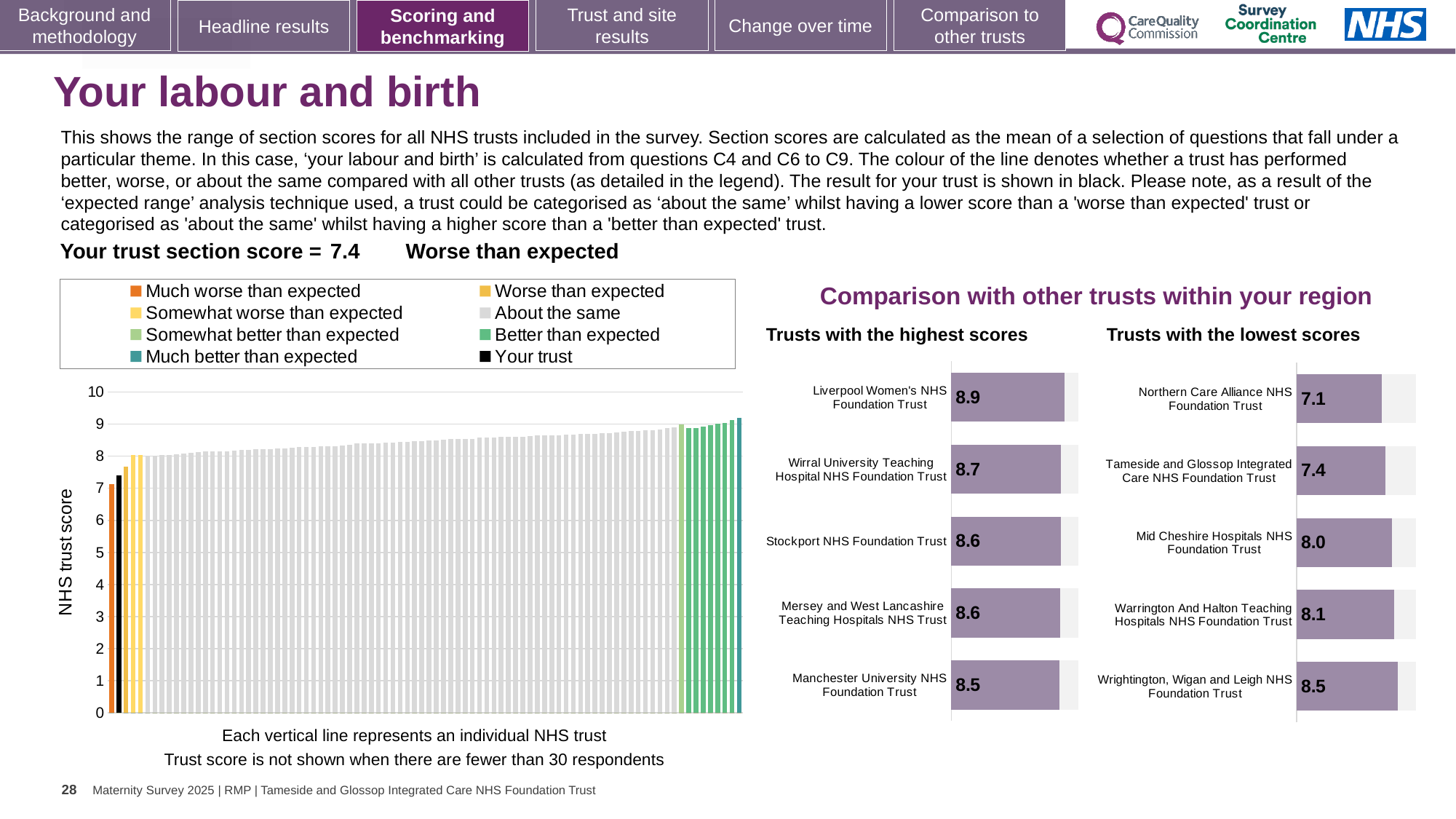
In the 'Trusts with the highest scores' chart, which trust has the highest score? Liverpool Women's NHS Foundation Trust In the 'Trusts with the highest scores' chart, how many trusts are listed? 5 In the NHS trust score chart on the left, how many entries does the legend list? 8 In the NHS trust score chart on the left, do the bar values rise or fall from left to right? Rise In the 'Trusts with the lowest scores' chart, which has the larger score: Mid Cheshire Hospitals NHS Foundation Trust or Warrington And Halton Teaching Hospitals NHS Foundation Trust? Warrington And Halton Teaching Hospitals NHS Foundation Trust In the 'Trusts with the lowest scores' chart, what is the score for Tameside and Glossop Integrated Care NHS Foundation Trust? 7.4 What kind of chart is the NHS trust score chart on the left of the slide? Bar chart In the 'Trusts with the highest scores' chart, what is the score for Liverpool Women's NHS Foundation Trust? 8.9 In the 'Trusts with the lowest scores' chart, what is the score for Northern Care Alliance NHS Foundation Trust? 7.1 In the 'Trusts with the lowest scores' chart, which trust has the lowest score? Northern Care Alliance NHS Foundation Trust In the NHS trust score chart on the left, is the value for the black 'Your trust' bar greater or less than 8? less In the 'Trusts with the highest scores' chart, what is the difference between the scores of Liverpool Women's NHS Foundation Trust and Manchester University NHS Foundation Trust? 0.4